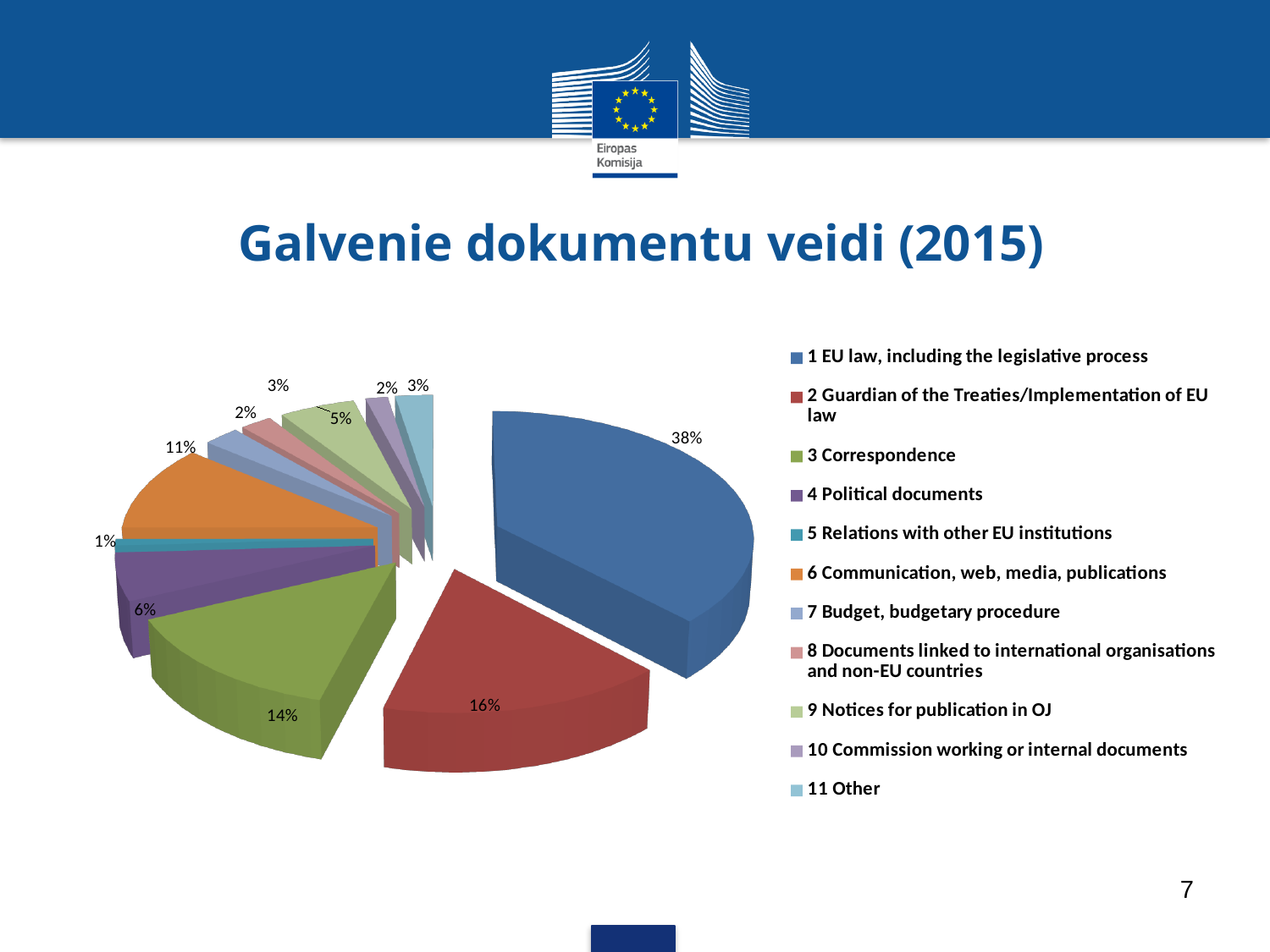
What share of the pie does '4 Political documents' have? 6% What share of the pie does '1 EU law, including the legislative process' have? 38% What is the difference in percentage points between '1 EU law, including the legislative process' and '2 Guardian of the Treaties/Implementation of EU law'? 22 percentage points What share of the pie does '2 Guardian of the Treaties/Implementation of EU law' have? 16% What type of chart is shown on the slide? Pie chart How many categories does the legend of the pie chart list? 11 Which has a larger share: '3 Correspondence' or '6 Communication, web, media, publications'? 3 Correspondence What is the title of the slide containing the chart? Galvenie dokumentu veidi (2015) Which category has the smallest share of the pie? 5 Relations with other EU institutions Which category has the largest share of the pie? 1 EU law, including the legislative process